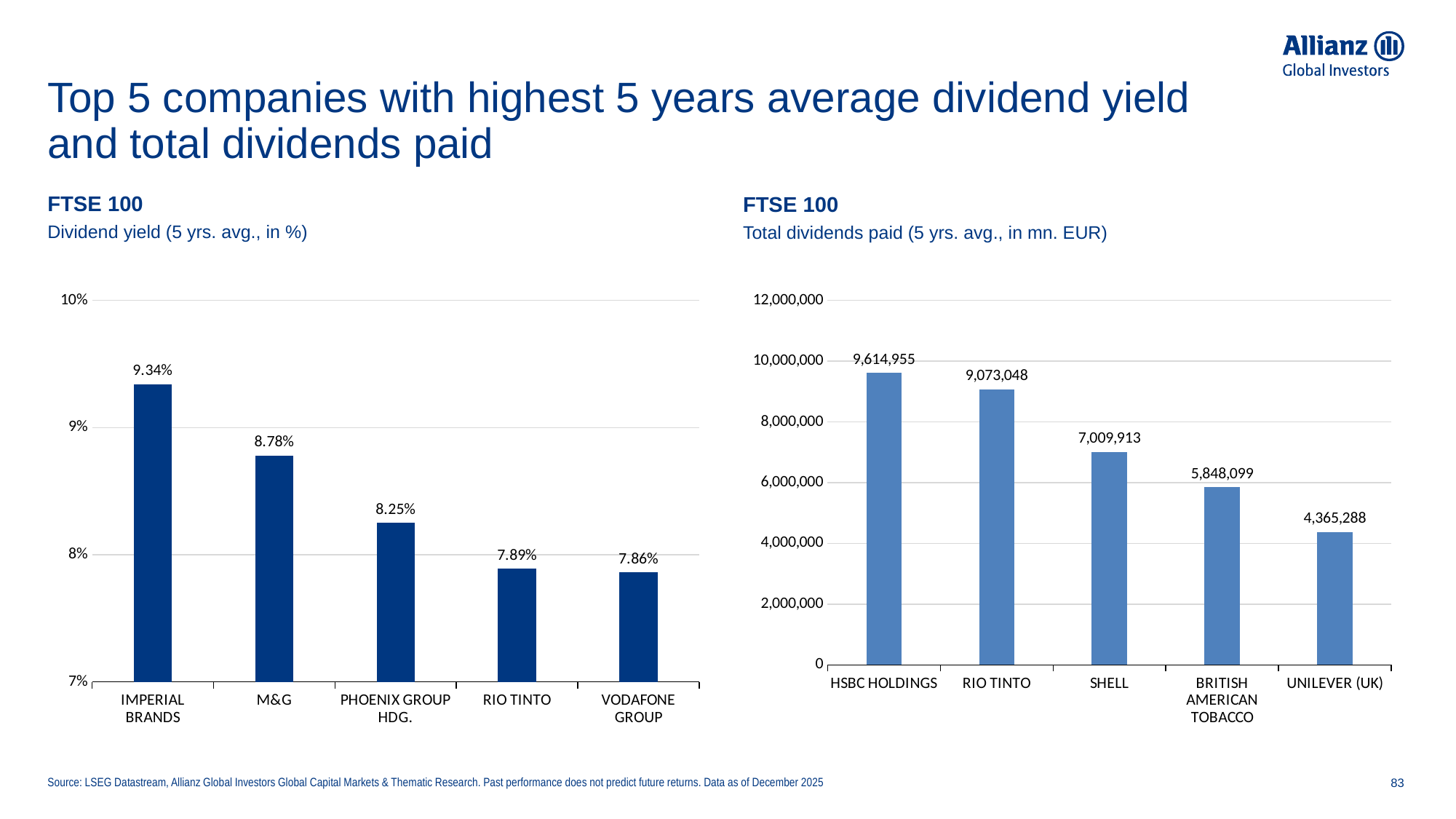
In the right chart (Total dividends paid), which company has the highest value? HSBC HOLDINGS In the left chart (Dividend yield), what is the value for IMPERIAL BRANDS? 9.34% What kind of chart is the right chart (Total dividends paid)? bar chart In the right chart (Total dividends paid), which is larger, BRITISH AMERICAN TOBACCO or UNILEVER (UK)? BRITISH AMERICAN TOBACCO In the left chart (Dividend yield), do the values rise or fall from left to right? fall In the right chart (Total dividends paid), what is the value for UNILEVER (UK)? 4,365,288 In the left chart (Dividend yield), what is the value for PHOENIX GROUP HDG.? 8.25% In the right chart (Total dividends paid), what is the value for SHELL? 7,009,913 In the left chart (Dividend yield), which company has the lowest value? VODAFONE GROUP In the right chart (Total dividends paid), what is the difference between RIO TINTO and SHELL? 2,063,135 In the left chart (Dividend yield), how many companies are shown? 5 In the left chart (Dividend yield), what is the difference between IMPERIAL BRANDS and M&G? 0.56 percentage points